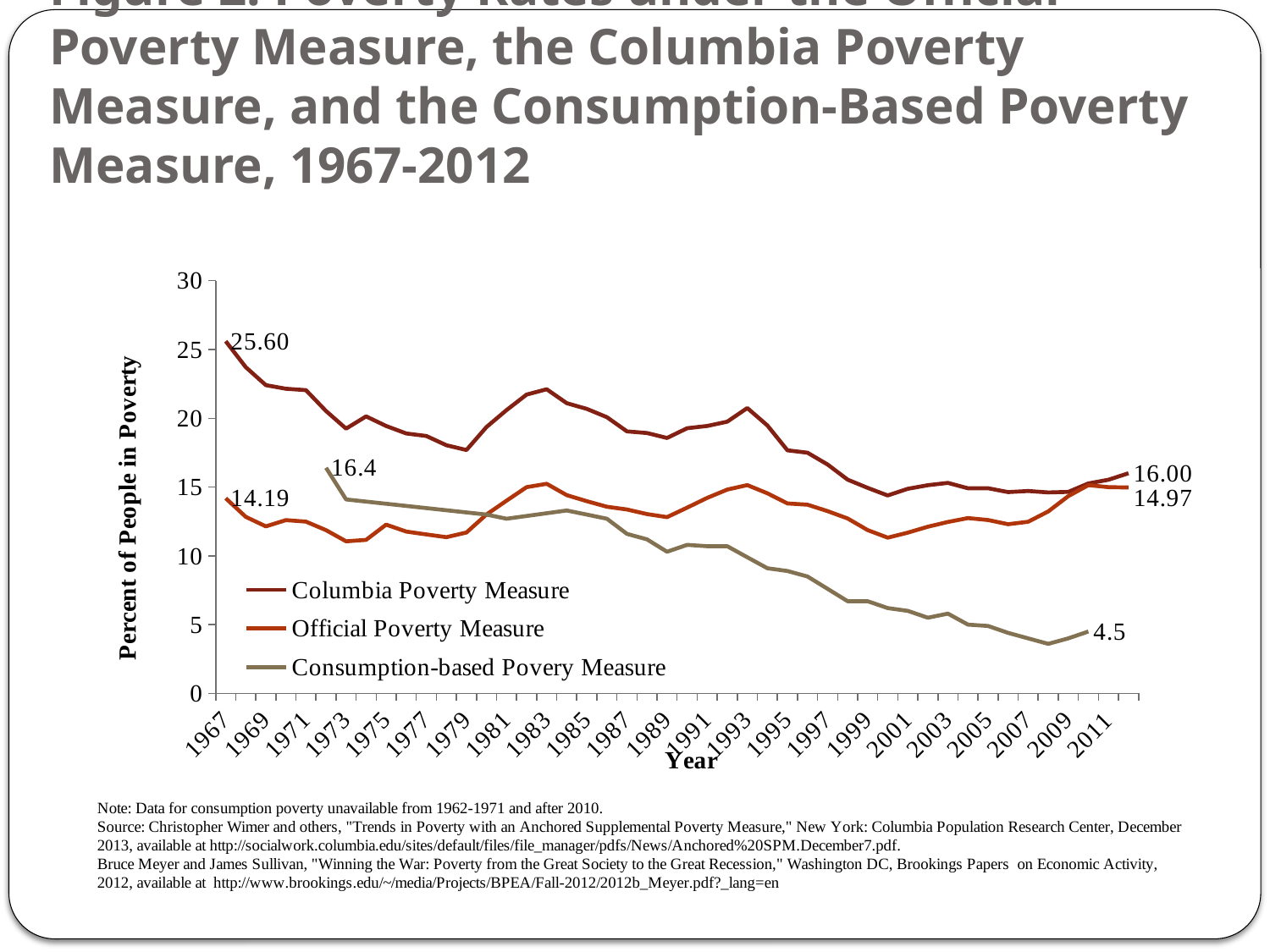
Does the Consumption-based Poverty Measure generally rise or fall over the years shown? fall What is the labeled value of the Columbia Poverty Measure at the start of the series in 1967? 25.60 Which was larger in 1967, the Columbia Poverty Measure or the Official Poverty Measure? Columbia Poverty Measure What is the labeled starting value of the Consumption-based Poverty Measure? 16.4 What is the labeled value of the Official Poverty Measure in 1967? 14.19 How many series does the legend list? 3 What is the labeled value of the Official Poverty Measure at the end of the series? 14.97 What is the difference between the Columbia Poverty Measure and the Official Poverty Measure in 1967? 11.41 What is the labeled final value of the Consumption-based Poverty Measure? 4.5 Is the value of the Consumption-based Poverty Measure in 1999 greater or less than 10? less What is the labeled value of the Columbia Poverty Measure at the end of the series? 16.00 What kind of chart is shown on the slide? line chart